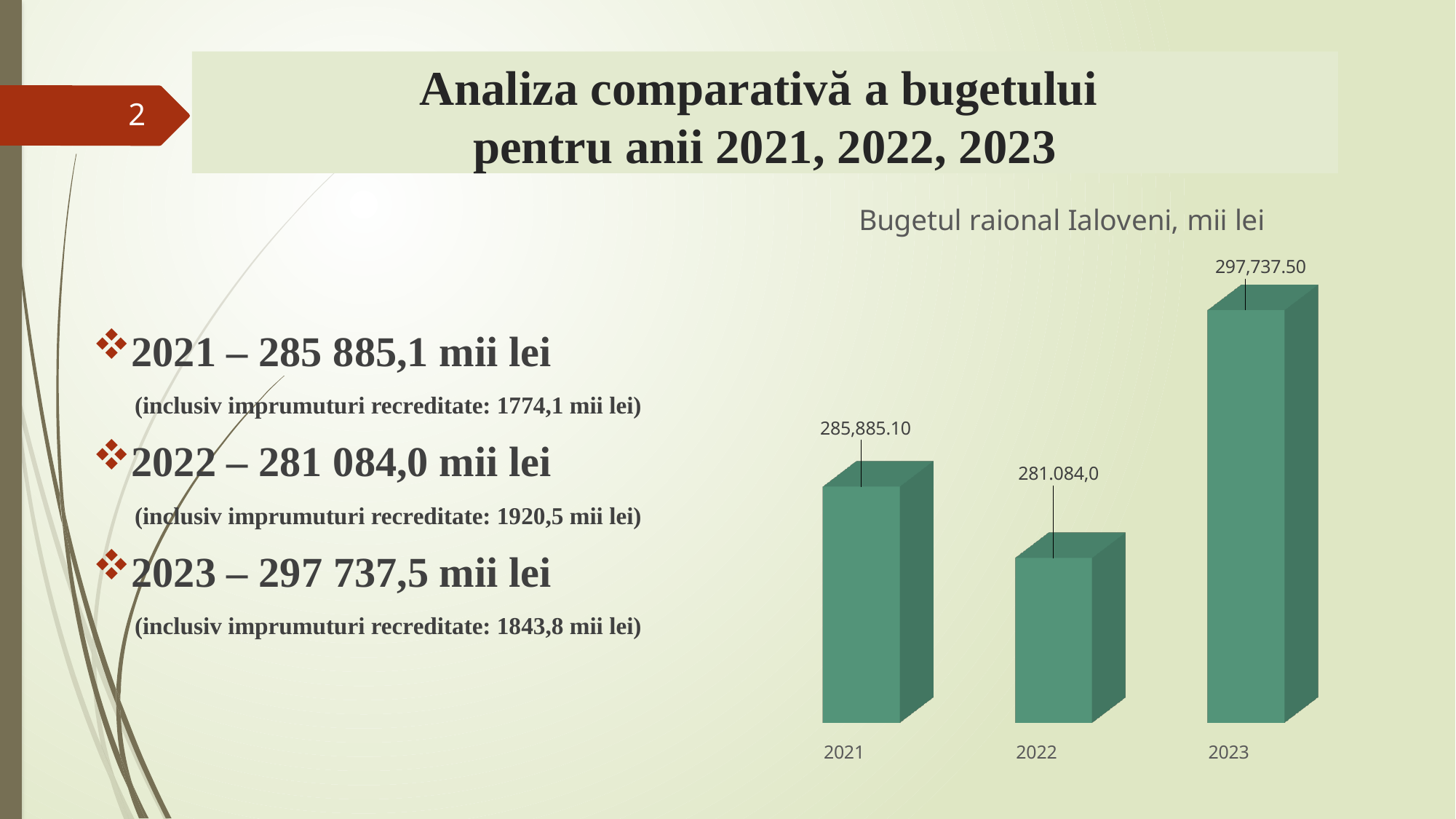
What is the value shown for 2023 in the chart? 297,737.50 What kind of chart is shown on the slide? bar chart What is the value shown for 2021 in the chart? 285,885.10 Which is larger, the value for 2021 or the value for 2022? 2021 What is the difference between the values for 2023 and 2021? 11,852.40 What is the difference between the values for 2021 and 2022? 4,801.10 Which year has the lowest value in the chart? 2022 What is the value shown for 2022 in the chart? 281.084,0 Is the value for 2023 larger or smaller than the value for 2021? larger Which year has the highest value in the chart? 2023 How many years are shown in the chart? 3 What is the title of the chart? Bugetul raional Ialoveni, mii lei